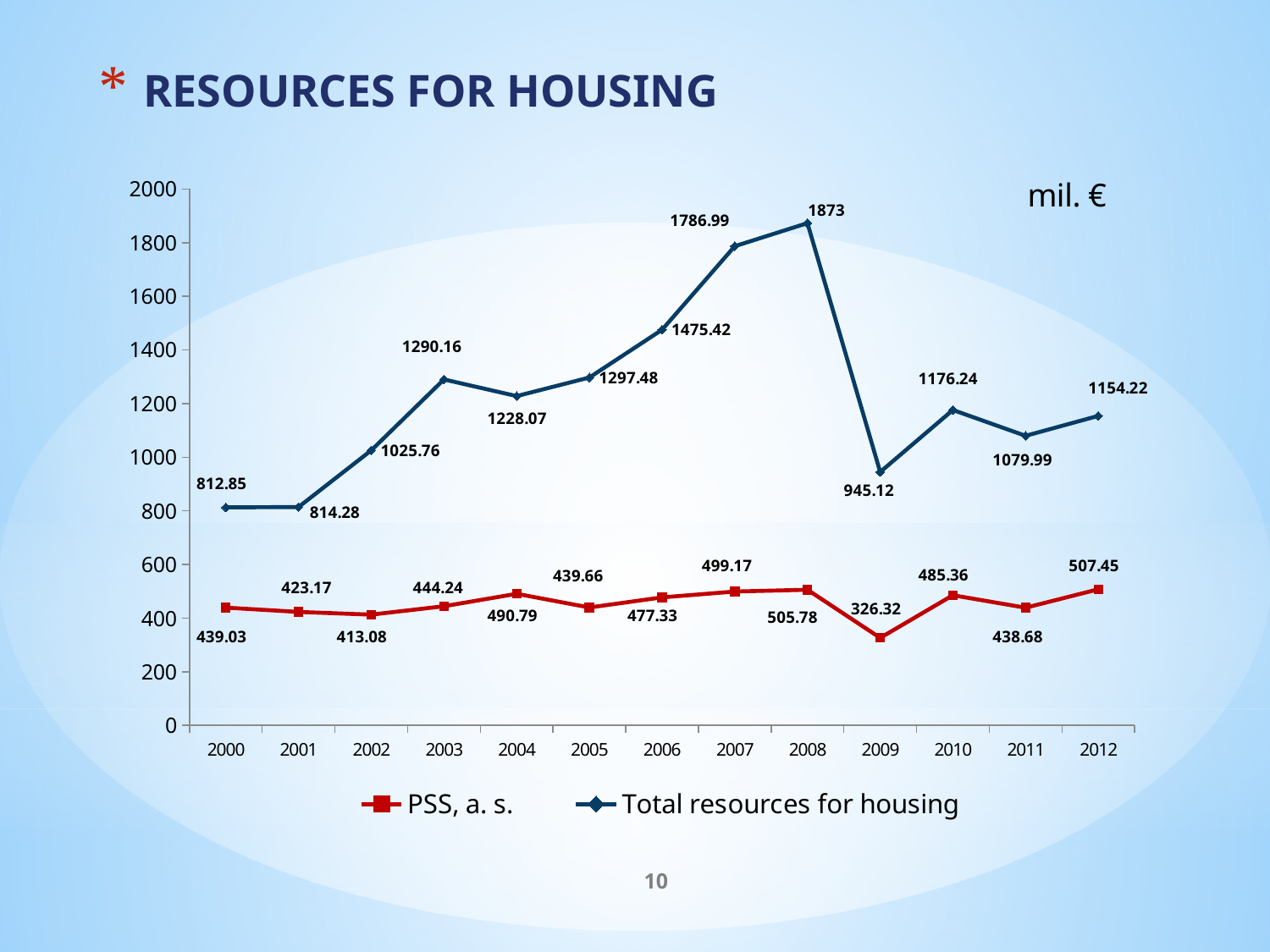
In which year is Total resources for housing highest? 2008 What is the value for PSS, a. s. in 2009? 326.32 What is the value of Total resources for housing in 2008? 1873 What kind of chart is shown on the slide? line chart In which year is the value for PSS, a. s. lowest? 2009 What is the difference between the PSS, a. s. values in 2012 and 2011? 68.77 What is the difference between Total resources for housing in 2008 and in 2007? 86.01 How many series does the legend list? 2 Is the value of Total resources for housing in 2009 greater or less than 1000? less How many years are shown on the x axis? 13 What is the value of Total resources for housing in 2003? 1290.16 Which year has the larger PSS, a. s. value, 2004 or 2005? 2004